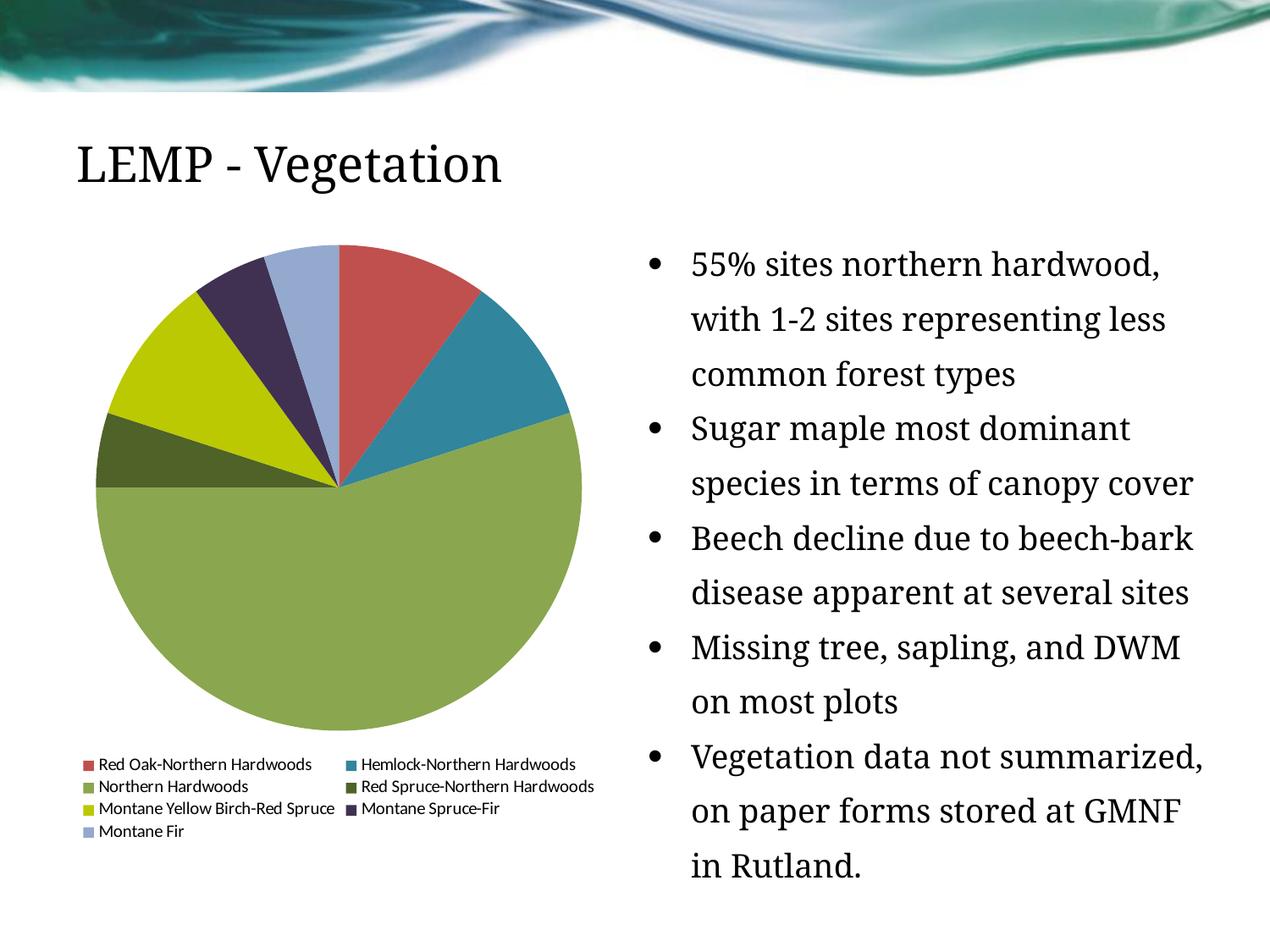
Which category has the largest slice in the pie chart? Northern Hardwoods Which slice is larger, Red Oak-Northern Hardwoods or Red Spruce-Northern Hardwoods? Red Oak-Northern Hardwoods What kind of chart is shown on the slide? pie chart Does the Northern Hardwoods slice take up more or less than half of the pie? more Which slice is larger, Hemlock-Northern Hardwoods or Montane Spruce-Fir? Hemlock-Northern Hardwoods According to the slide text, what share of sites are northern hardwood? 55% Which slice is larger, Northern Hardwoods or Red Oak-Northern Hardwoods? Northern Hardwoods What colour is the Northern Hardwoods slice in the pie chart? green How many entries does the legend of the pie chart list? 7 How many categories does the pie chart have? 7 Which legend entry is shown in red? Red Oak-Northern Hardwoods